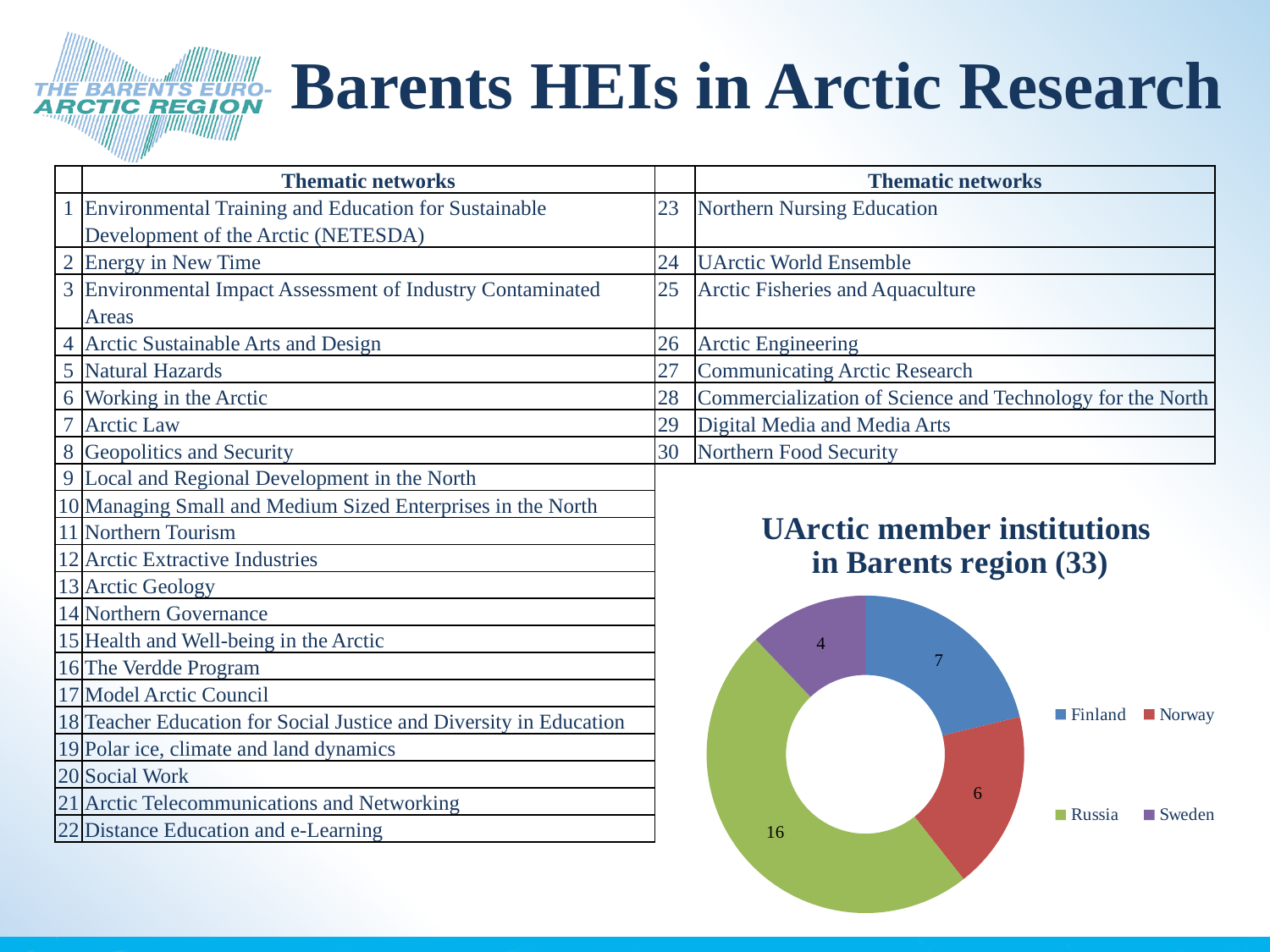
How many UArctic member institutions in the Barents region are in Sweden according to the chart? 4 What is the title of the chart on the slide? UArctic member institutions in Barents region (33) What is the total number of UArctic member institutions shown in the chart? 33 What kind of chart is shown on the slide? Doughnut chart How many UArctic member institutions in the Barents region are in Russia according to the chart? 16 Which country has the most UArctic member institutions in the Barents region? Russia How many UArctic member institutions in the Barents region are in Finland according to the chart? 7 How many countries does the chart legend list? 4 Which country has the fewest UArctic member institutions in the Barents region? Sweden What is the difference between the number of UArctic member institutions in Russia and in Finland? 9 How many UArctic member institutions in the Barents region are in Norway according to the chart? 6 Which has more UArctic member institutions in the Barents region, Finland or Norway? Finland